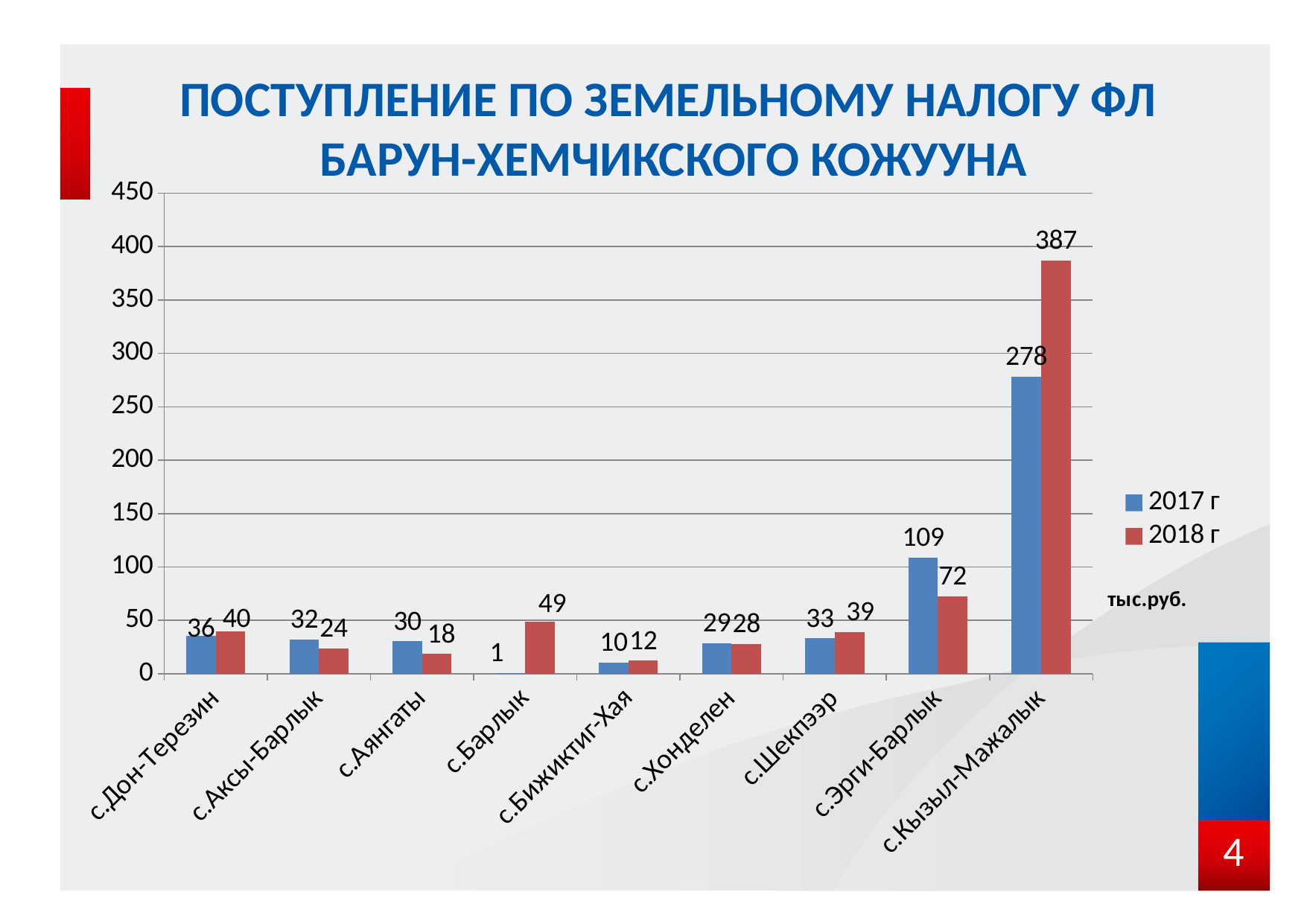
Is the 2018 г value for с.Кызыл-Мажалык greater or less than 350? greater How many series does the legend list? 2 How many categories are shown on the x axis? 9 What is the 2017 г value for с.Аянгаты? 30 What is the 2018 г value for с.Барлык? 49 What kind of chart is shown on the slide? bar chart Which category has the highest 2018 г value? с.Кызыл-Мажалык What is the difference between the 2018 г and 2017 г values for с.Кызыл-Мажалык? 109 What unit label is shown next to the chart? тыс.руб. Which category has the lowest 2017 г value? с.Барлык Which is larger for с.Эрги-Барлык, the 2017 г value or the 2018 г value? 2017 г What is the 2017 г value for с.Эрги-Барлык? 109